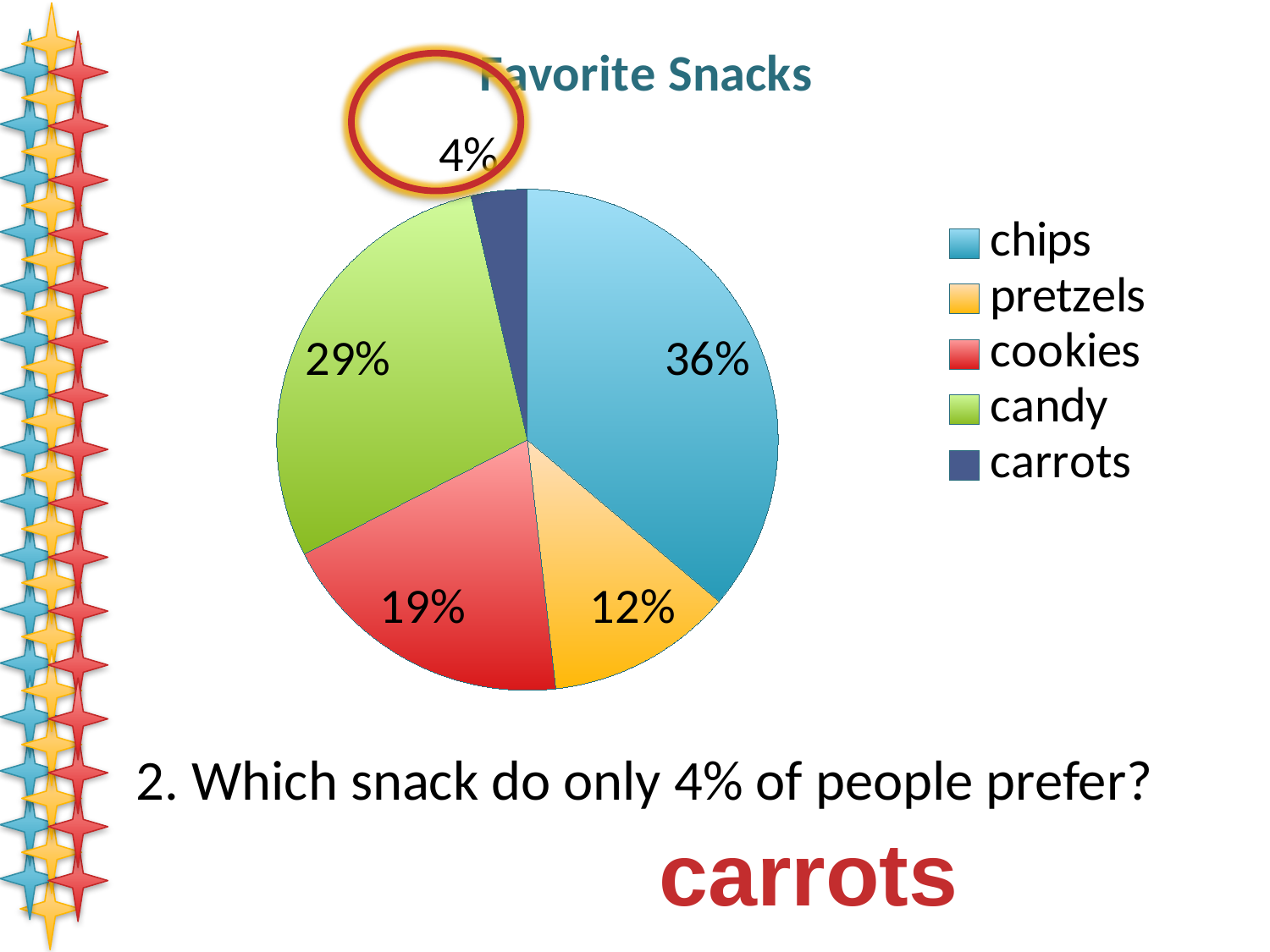
What is the title of the chart? Favorite Snacks What percentage of people prefer pretzels? 12% What percentage of people prefer chips? 36% How many snack categories are shown in the pie chart? 5 Which has a larger share, cookies or pretzels? cookies Which snack has the smallest share of the pie? carrots What percentage of people prefer candy? 29% What is the difference in percentage points between cookies and pretzels? 7 What percentage of people prefer cookies? 19% What kind of chart is shown on the slide? pie chart Which snack has the largest share of the pie? chips What is the difference in percentage points between chips and candy? 7